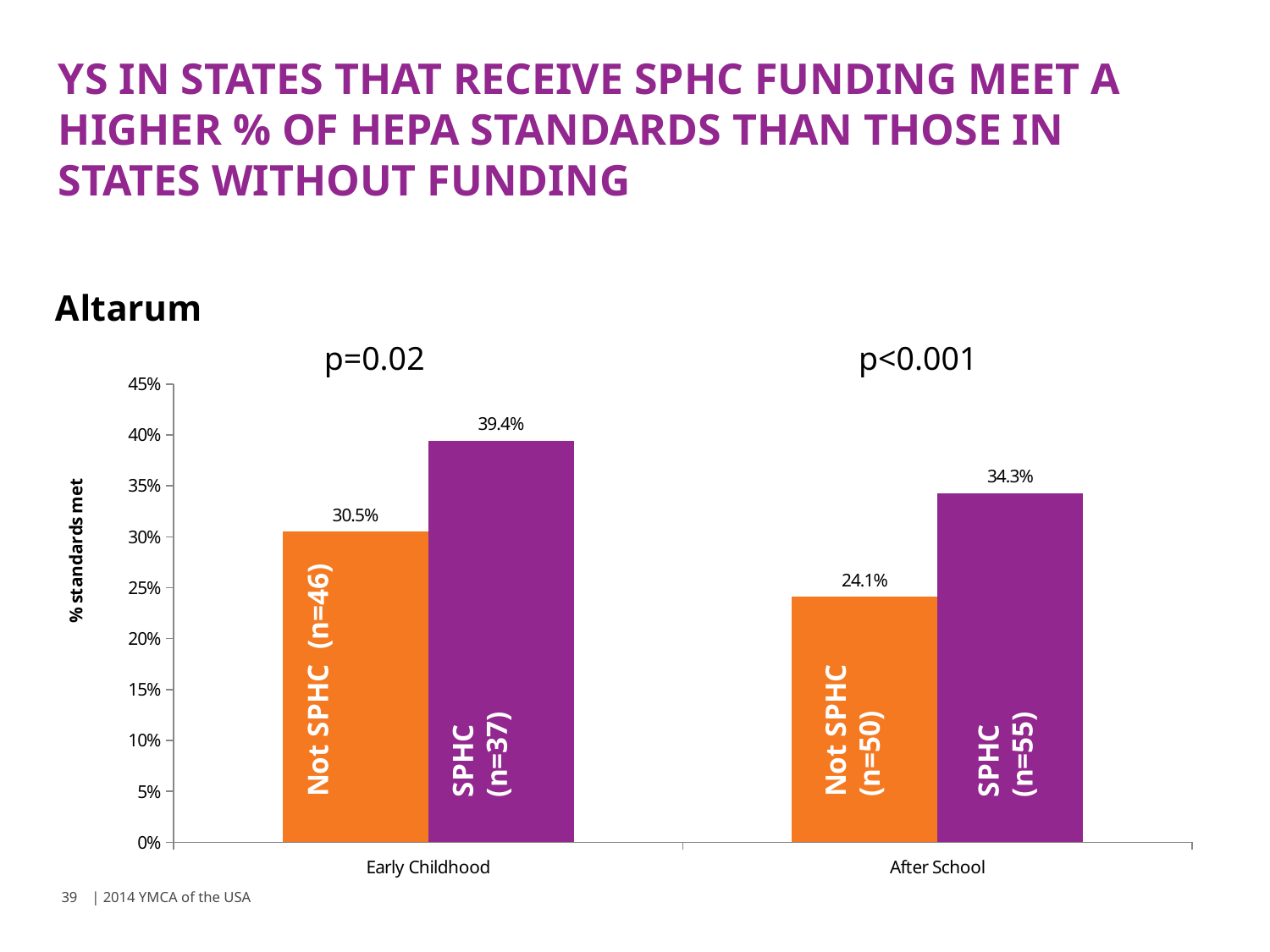
In the After School category, which group meets a higher % of standards, SPHC or Not SPHC? SPHC Which bar shows the lowest % of standards met? Not SPHC (n=50), After School What percentage of standards is met by SPHC Ys in the Early Childhood category? 39.4% What percentage of standards is met by Not SPHC Ys in the After School category? 24.1% What percentage of standards is met by SPHC Ys in the After School category? 34.3% Which bar shows the highest % of standards met? SPHC (n=37), Early Childhood How many categories are shown on the x axis of the chart? 2 What is the difference in % standards met between SPHC and Not SPHC Ys in the Early Childhood category? 8.9% What is the p-value shown above the Early Childhood bars? p=0.02 What kind of chart is shown on the slide? Bar chart What percentage of standards is met by Not SPHC Ys in the Early Childhood category? 30.5% What is the difference in % standards met between SPHC and Not SPHC Ys in the After School category? 10.2%